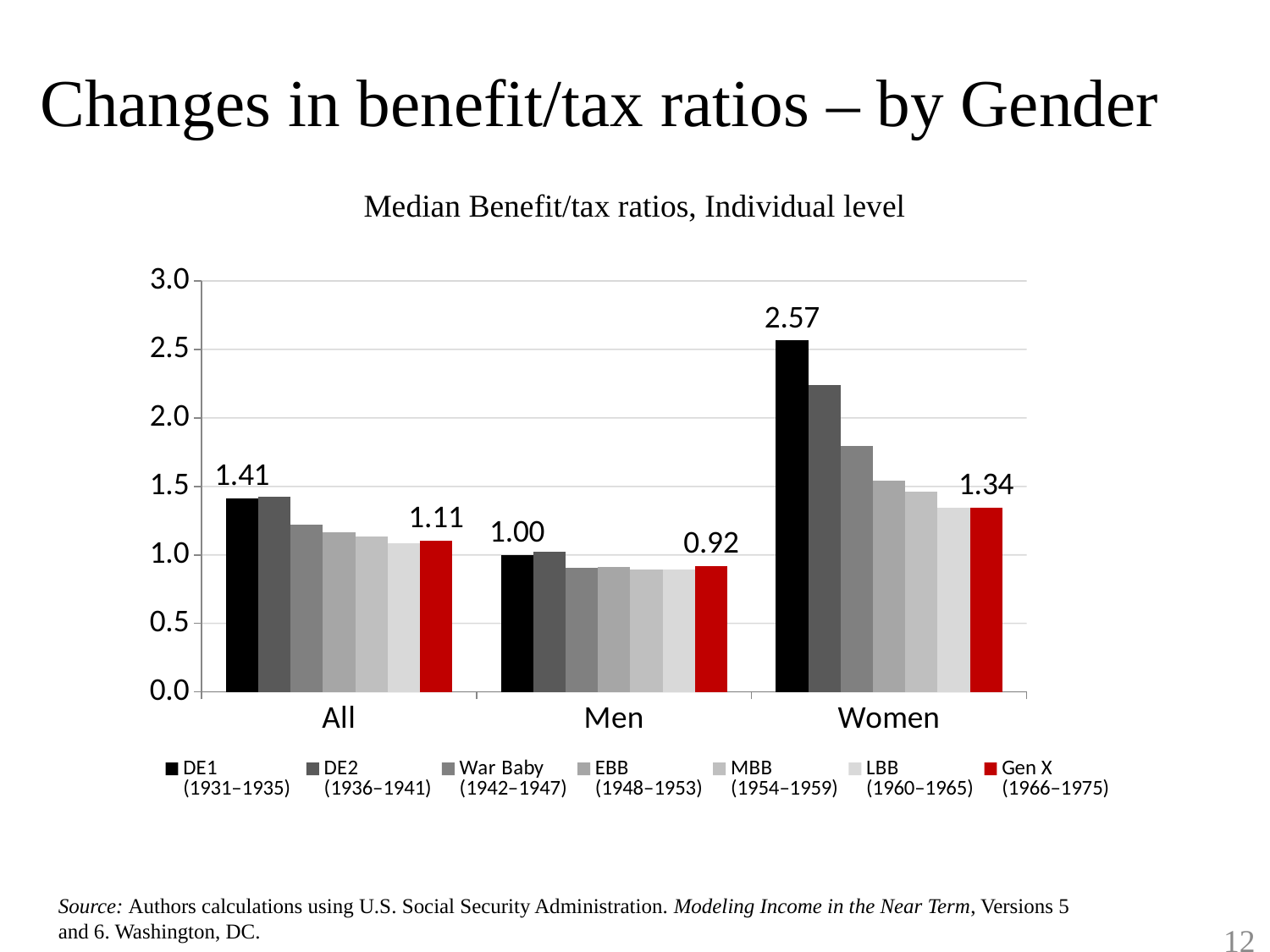
What is the median benefit/tax ratio for Gen X (1966–1975) in the All group? 1.11 Is the DE2 (1936–1941) value for Women greater or less than 2.0? greater Which group has the highest DE1 (1931–1935) value? Women What is the median benefit/tax ratio for DE1 (1931–1935) in the Women group? 2.57 Is the Gen X value for Men larger or smaller than the Gen X value for Women? smaller Which group has the lowest Gen X (1966–1975) value? Men What is the difference between the DE1 and Gen X values in the Women group? 1.23 What is the difference between the DE1 and Gen X values in the All group? 0.30 What is the median benefit/tax ratio for Gen X (1966–1975) in the Women group? 1.34 What type of chart is shown on the slide? Bar chart What is the median benefit/tax ratio for DE1 (1931–1935) in the Men group? 1.00 How many series does the legend list? 7